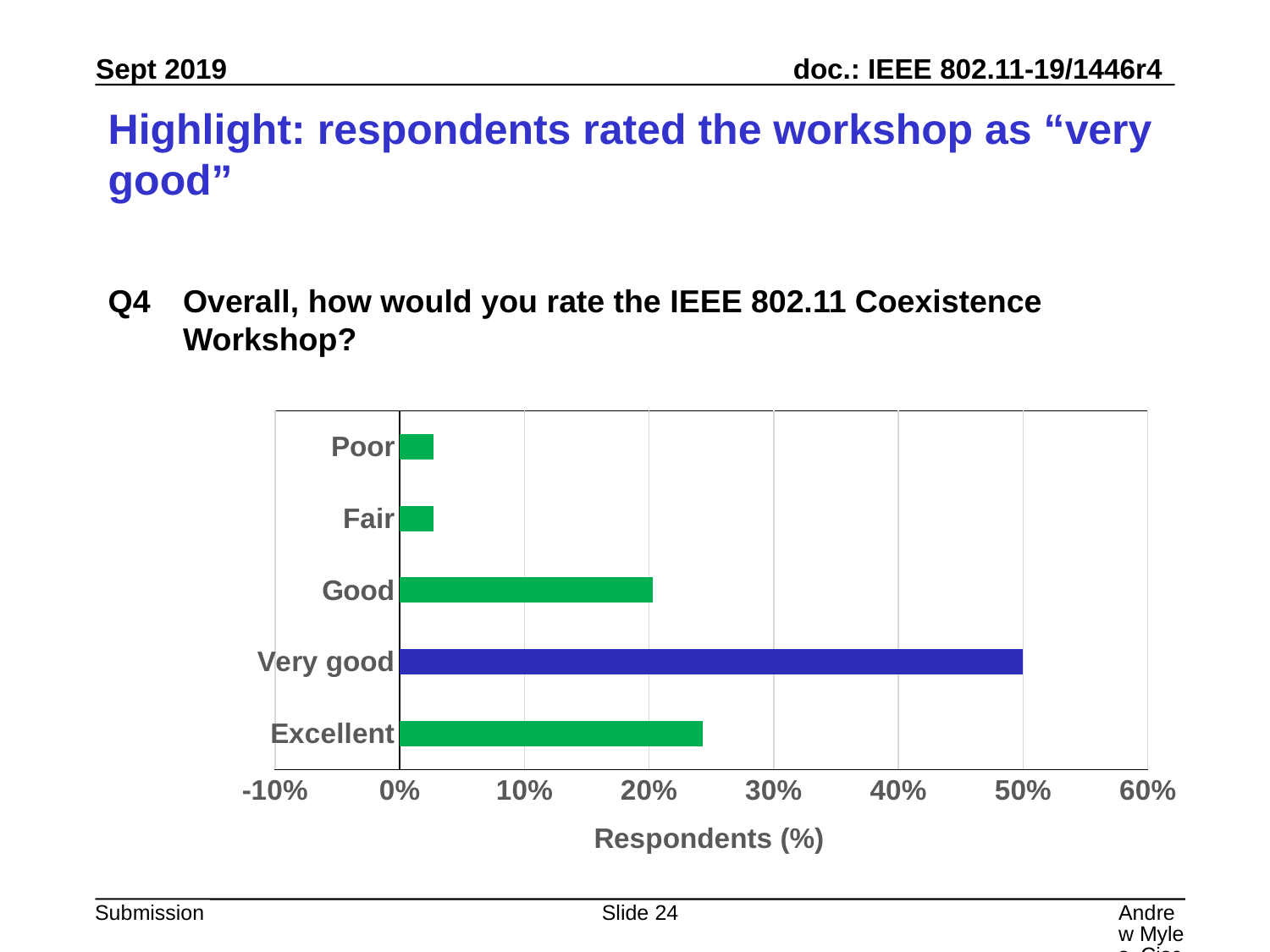
What percentage of respondents rated the workshop as "Very good"? 50% Is the value for "Good" greater or less than 30%? less How many rating categories are plotted in the chart? 5 What is the title of the horizontal axis of the chart? Respondents (%) Which has a larger share of respondents, "Excellent" or "Good"? Excellent Which has a larger share of respondents, "Very good" or "Excellent"? Very good Is the value for "Fair" greater or less than 10%? less Is the value for "Excellent" greater or less than 20%? greater What kind of chart is shown on the slide? bar chart Which rating category has the highest percentage of respondents? Very good Which bar in the chart is coloured blue rather than green? Very good